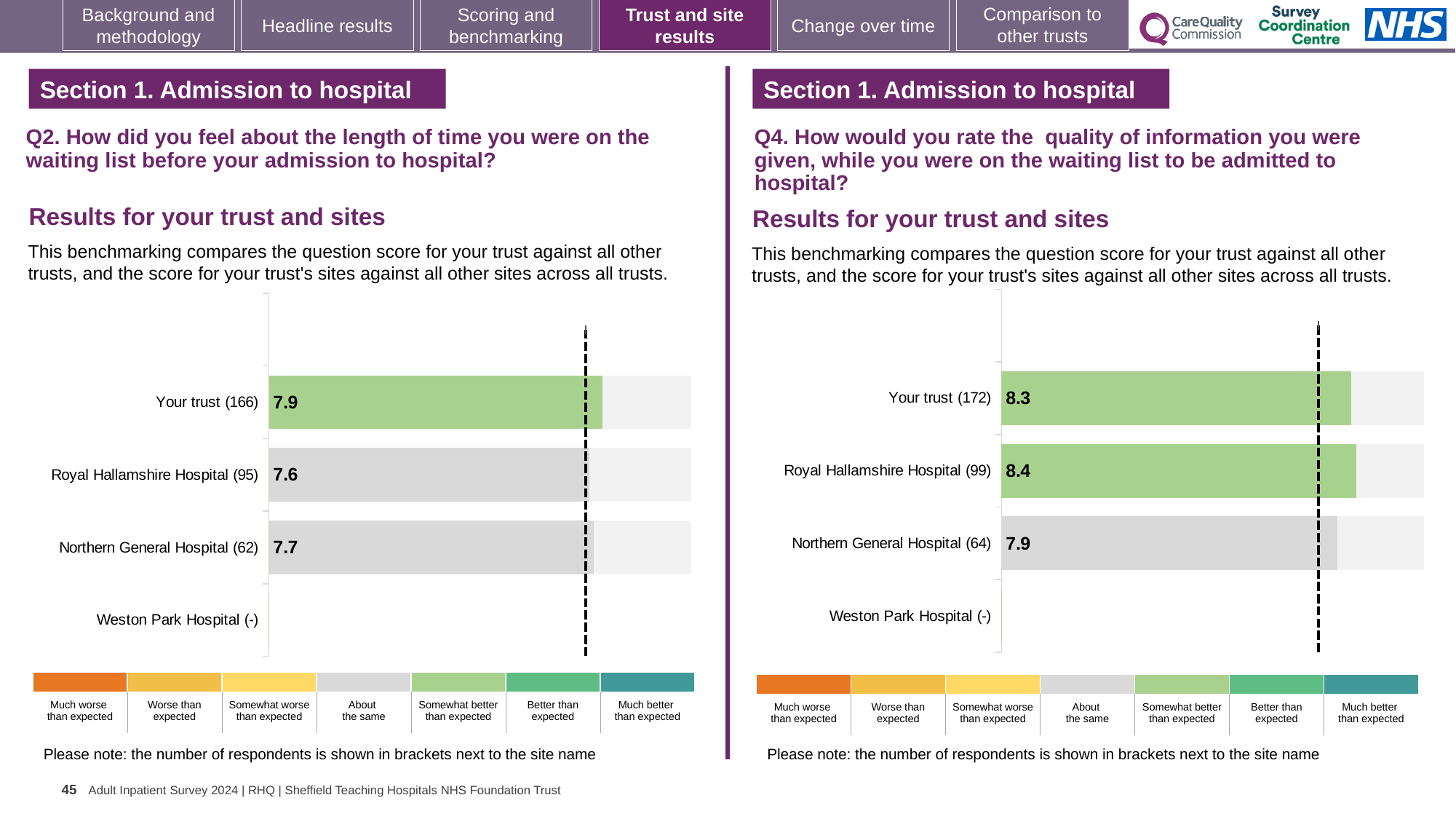
On the left chart (Q2), which site or trust has the lowest score? Royal Hallamshire Hospital On the right chart (Q4), what is the score for Northern General Hospital? 7.9 On the right chart (Q4), which is larger: the score for Your trust or the score for Northern General Hospital? Your trust On the right chart (Q4), how many categories are listed on the vertical axis? 4 On the left chart (Q2), what is the score for Royal Hallamshire Hospital? 7.6 On the right chart (Q4), which site or trust has the highest score? Royal Hallamshire Hospital On the left chart (Q2), what is the score for Your trust? 7.9 On the right chart (Q4), what is the difference between the scores for Royal Hallamshire Hospital and Northern General Hospital? 0.5 On the right chart (Q4), which benchmark category does the green colour of the Your trust bar correspond to in the legend? Somewhat better than expected On the left chart (Q2), what is the difference between the scores for Your trust and Northern General Hospital? 0.2 On the left chart (Q2), how many respondents are shown in brackets for Northern General Hospital? 62 What type of chart is used on the left (Q2)? Bar chart